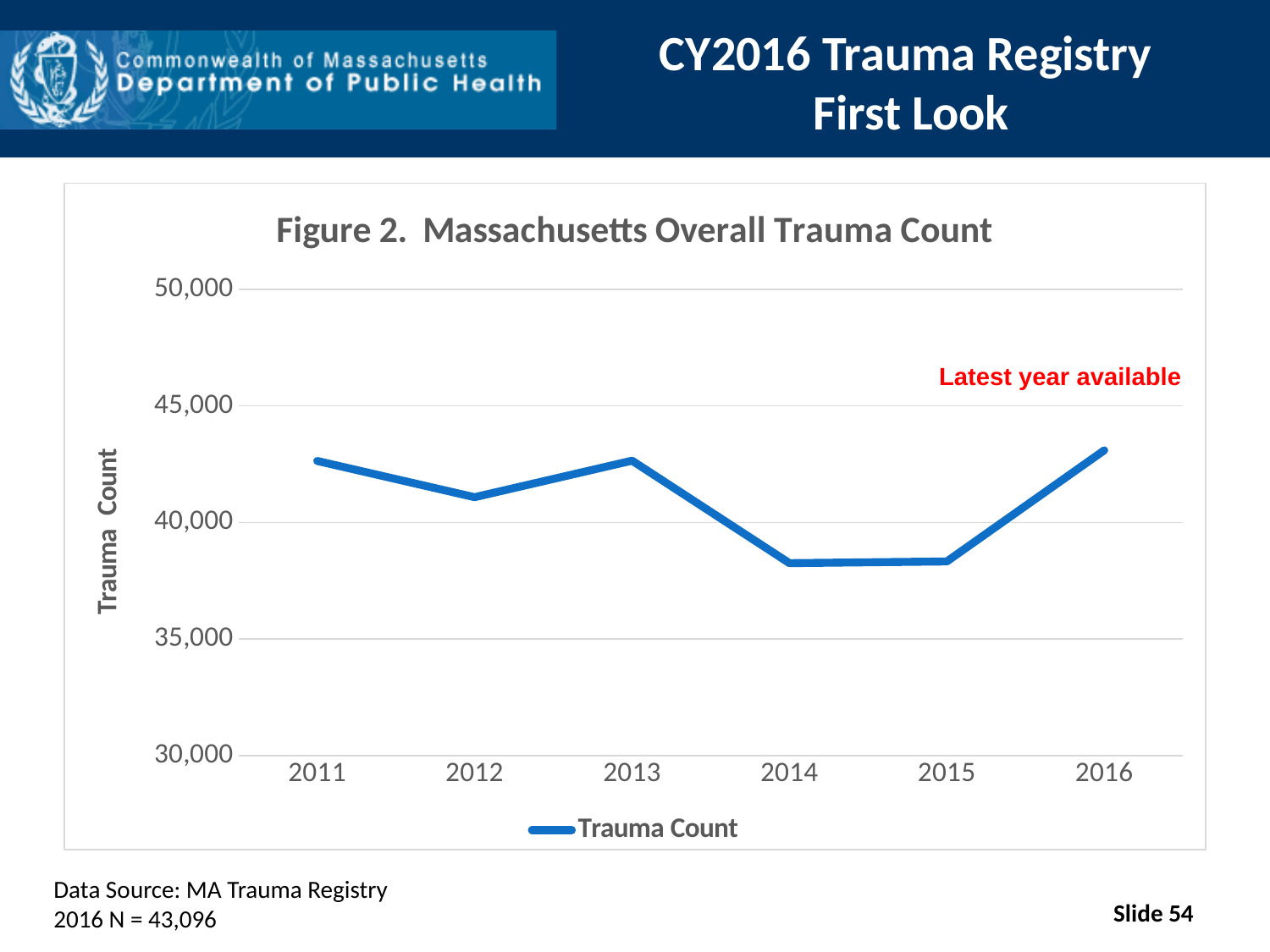
What is the trauma count for 2016, as stated on the slide? 43,096 Does the trauma count rise or fall from 2015 to 2016? rise What is the title of the chart on the slide? Figure 2. Massachusetts Overall Trauma Count Which year has the larger trauma count, 2012 or 2013? 2013 What kind of chart is Figure 2, Massachusetts Overall Trauma Count? line chart Is the trauma count for 2013 greater or less than 45,000? less What is the label of the series shown in the chart legend? Trauma Count How many series does the legend of the chart list? 1 Is the trauma count for 2012 greater or less than 40,000? greater Does the trauma count rise or fall from 2013 to 2014? fall Is the trauma count for 2014 greater or less than 40,000? less How many years are plotted on the x axis of the chart? 6